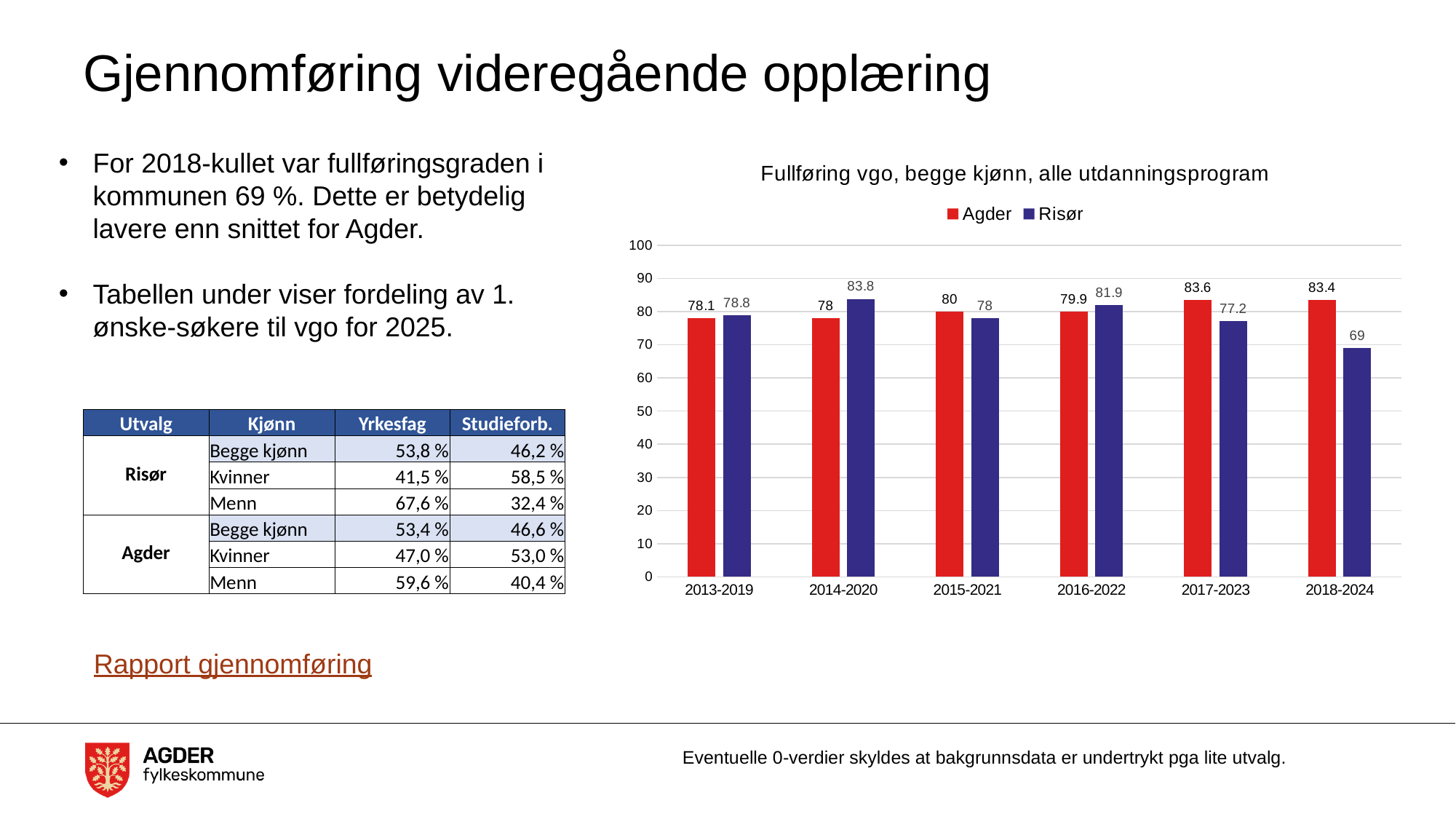
In which period is the Risør value lowest? 2018-2024 Which is larger in 2016-2022, Agder or Risør? Risør In which period is the Risør value highest? 2014-2020 What is the title of the chart? Fullføring vgo, begge kjønn, alle utdanningsprogram How many series does the legend list? 2 What kind of chart is shown? Bar chart What is the difference between Agder and Risør in 2018-2024? 14.4 What is the value for Agder in 2013-2019? 78.1 How many periods are shown on the x axis? 6 What is the value for Risør in 2014-2020? 83.8 What is the value for Agder in 2017-2023? 83.6 What is the value for Risør in 2018-2024? 69